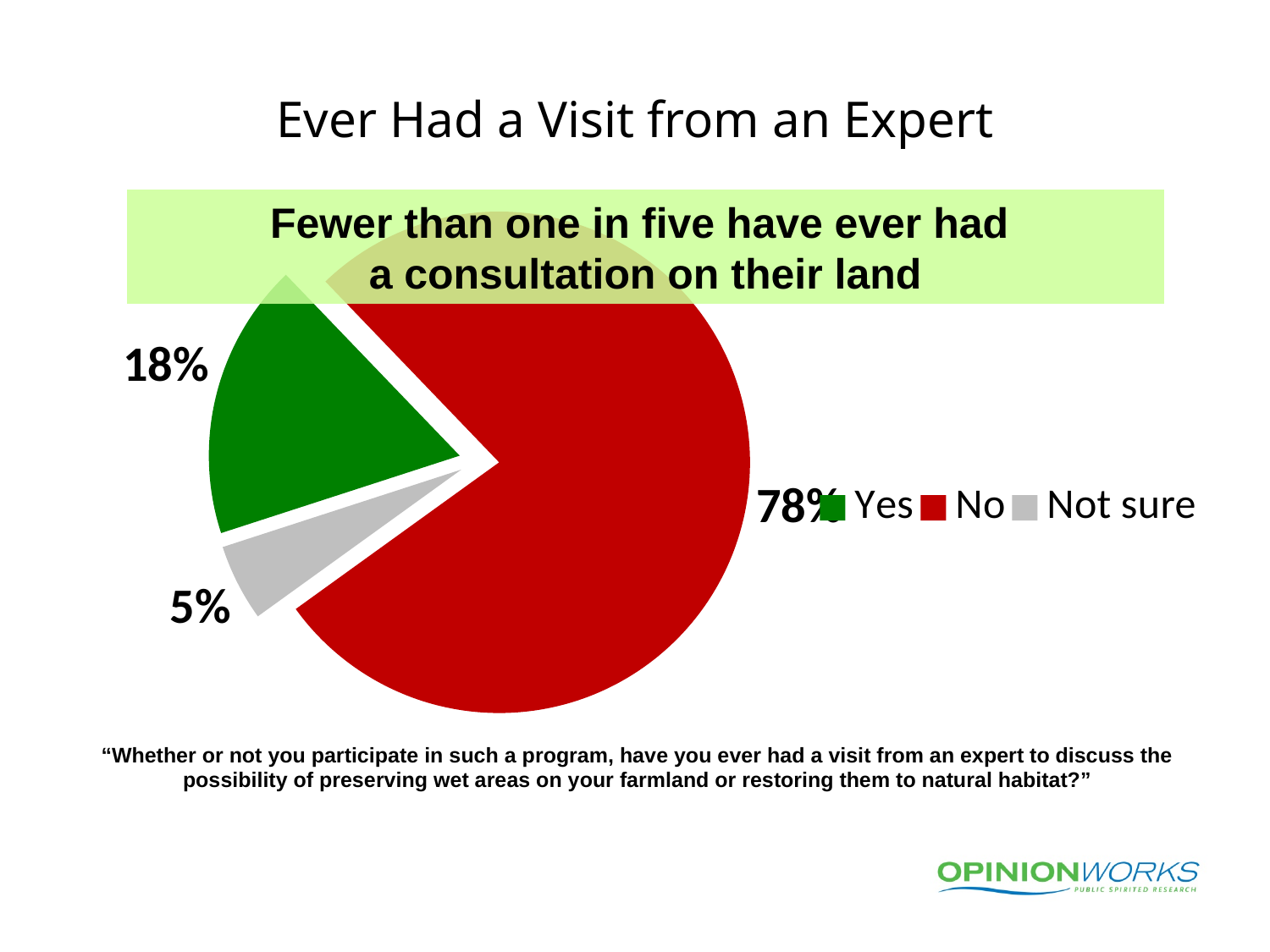
How many slices does the pie chart have? 3 Which response has the largest share of the pie? No Which response has the smallest share of the pie? Not sure What colour is the No slice? red What is the difference in percentage points between the Yes and Not sure slices? 13 What is the difference in percentage points between the No and Yes slices? 60 What percentage of respondents answered Yes? 18% What percentage of respondents answered Not sure? 5% How many entries does the legend list? 3 Which is larger, the Yes slice or the Not sure slice? Yes What percentage of respondents answered No? 78% What kind of chart is shown on the slide? pie chart